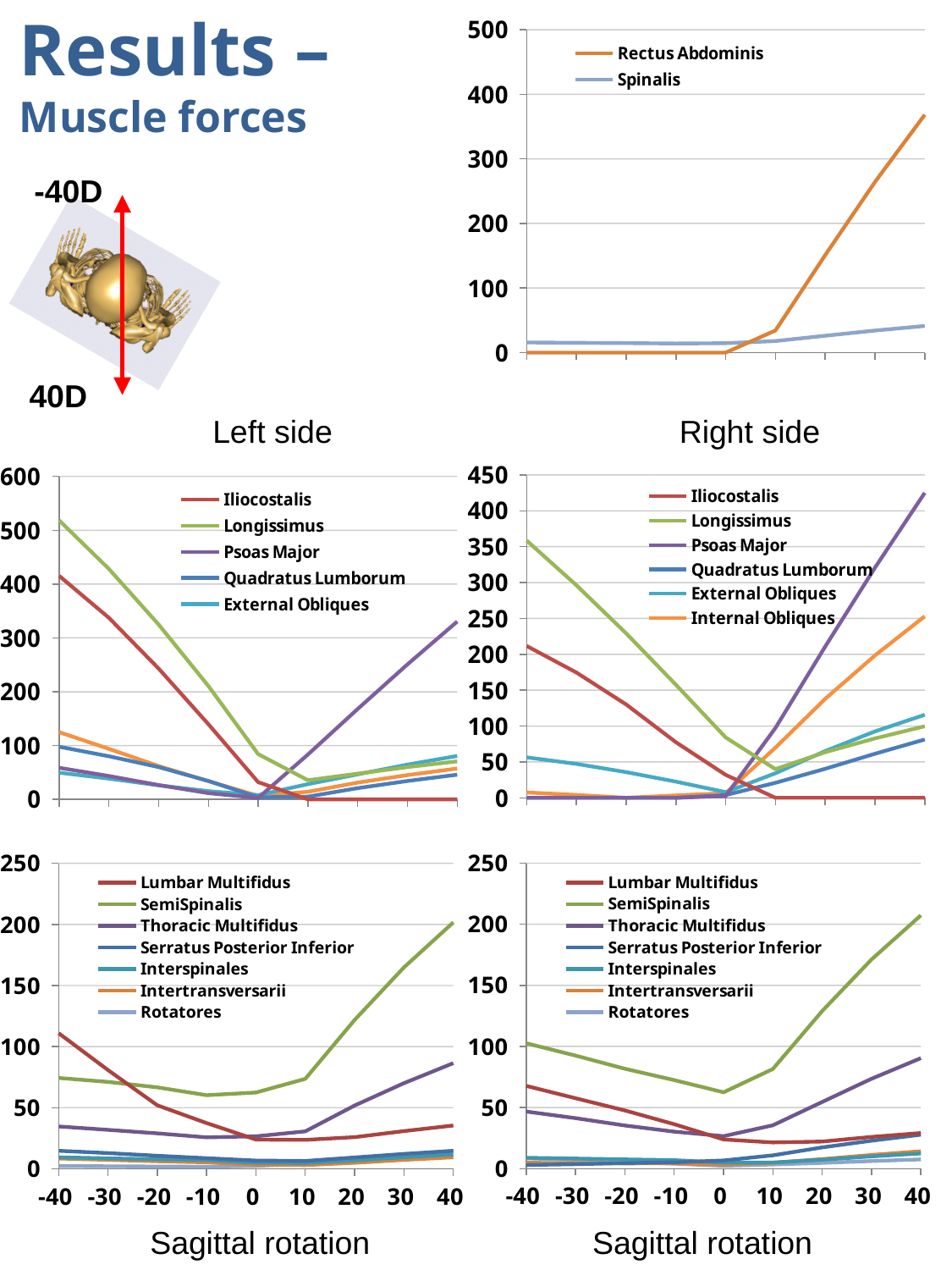
In the bottom-right chart, is the value for SemiSpinalis at 40 greater or less than 150? greater What kind of chart is the top-right chart with Rectus Abdominis and Spinalis? line chart In the Left side chart (middle left), which series has the highest value at -40? Longissimus In the bottom-left chart, which series has the highest value at 40? SemiSpinalis In the Right side chart (middle right), how many series does the legend list? 6 In the top-right chart, does Rectus Abdominis rise or fall between 0 and 40? rise In the Left side chart (middle left), how many series does the legend list? 5 In the top-right chart, is the value for Rectus Abdominis at 40 greater or less than 300? greater In the Left side chart (middle left), is the value for Longissimus at -40 greater or less than 400? greater In the top-right chart, how many series does the legend list? 2 In the Left side chart (middle left), which is larger at -40, Iliocostalis or Psoas Major? Iliocostalis In the Right side chart (middle right), which series has the highest value at 40? Psoas Major